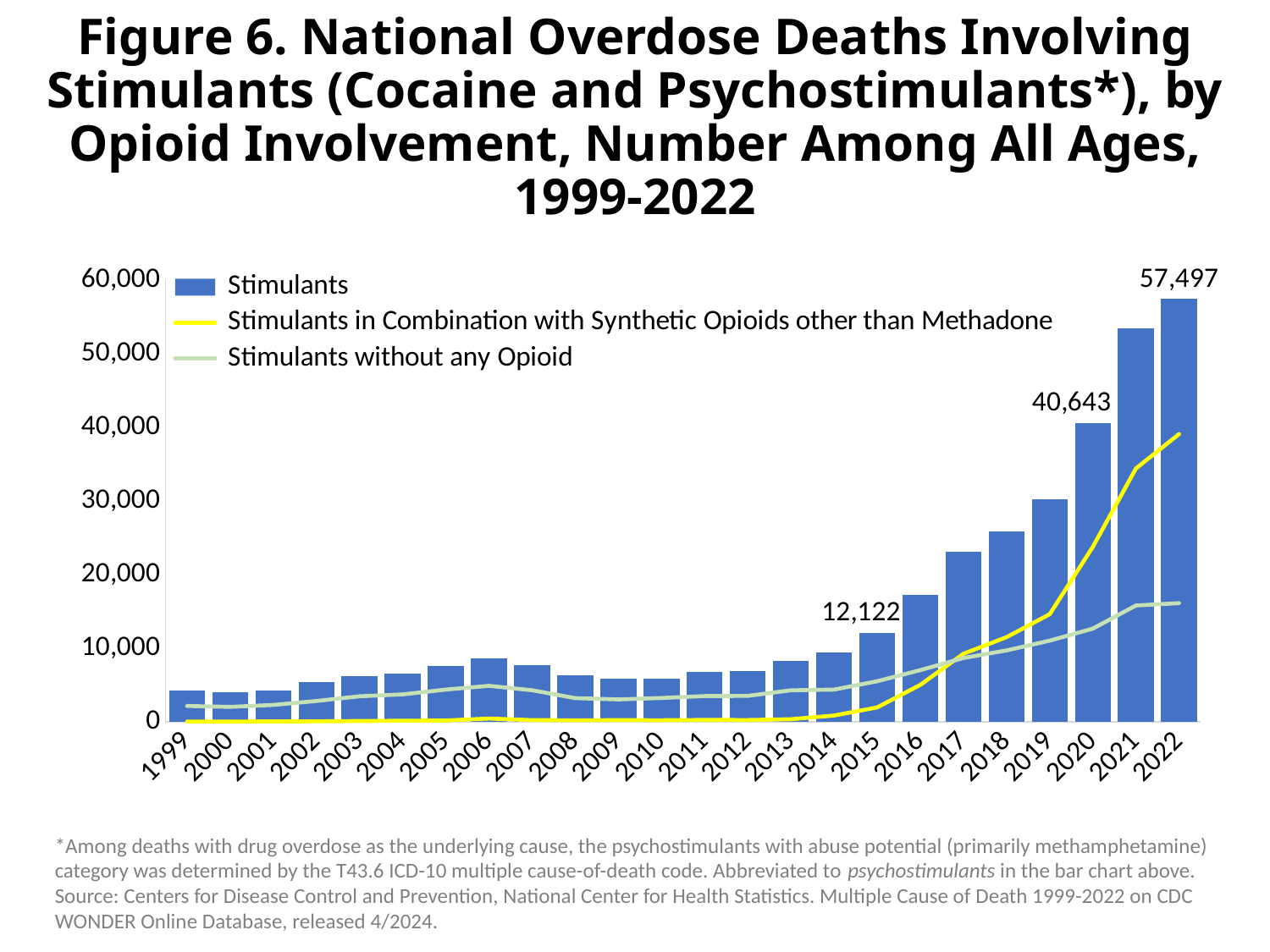
What is the number of stimulant overdose deaths shown for 2022? 57,497 Which series is drawn as a yellow line in the legend? Stimulants in Combination with Synthetic Opioids other than Methadone What value is labelled on the Stimulants bar for 2020? 40,643 Which year has the highest Stimulants bar? 2022 What is the difference between the labelled Stimulants values for 2020 and 2015? 28,521 What value is labelled on the Stimulants bar for 2015? 12,122 How many series does the legend list? 3 By how much did the labelled Stimulants value increase from 2020 to 2022? 16,854 Is the Stimulants bar for 2021 greater or less than 50,000? greater How many years are shown on the x axis? 24 Is the Stimulants bar for 2016 greater or less than 20,000? less